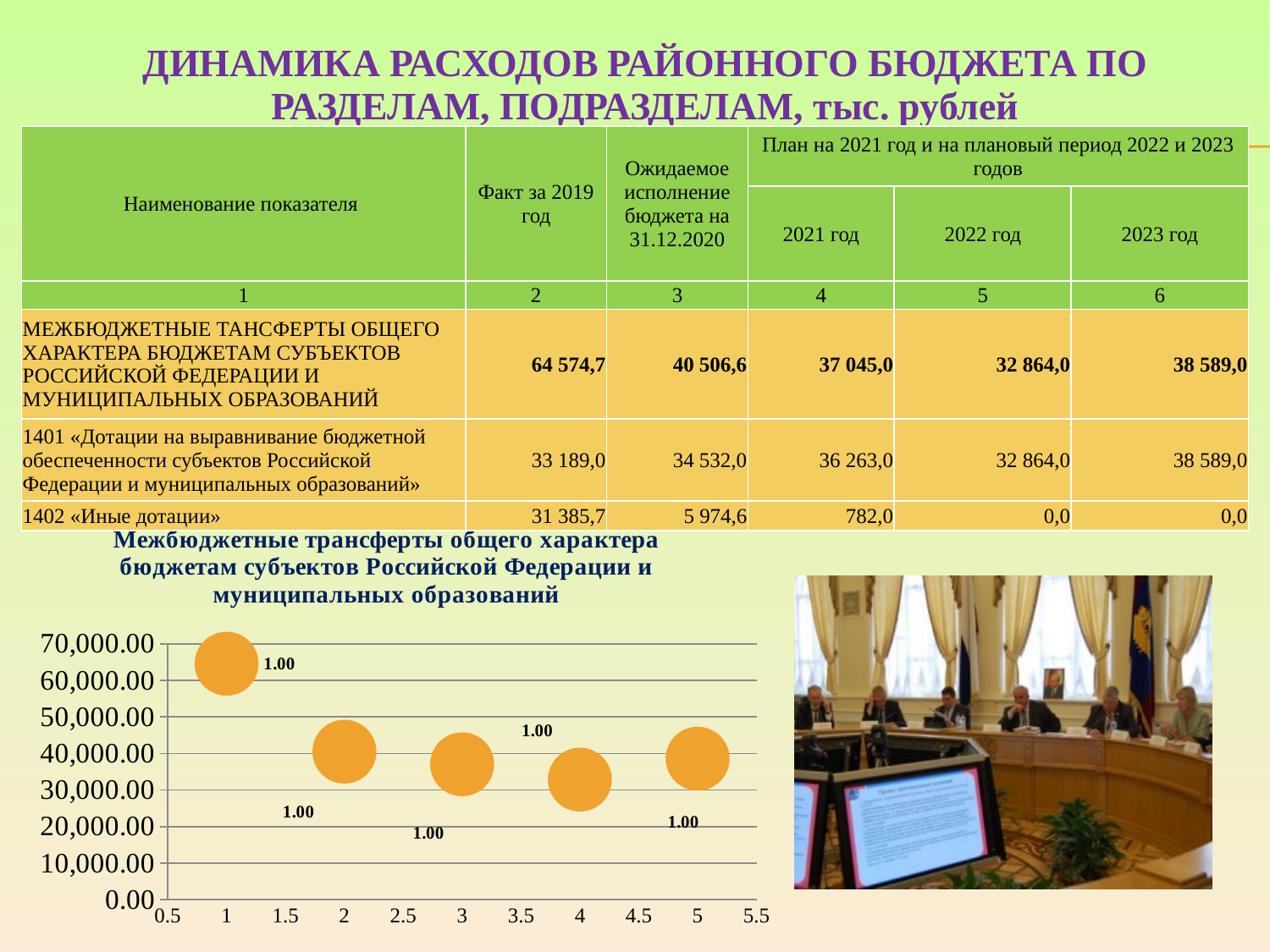
Is the value of the bubble at x = 2 greater or less than 30,000.00? greater Is the value of the bubble at x = 1 greater or less than 60,000.00? greater Is the value of the bubble at x = 5 greater or less than 50,000.00? less Which bubble has the larger value, the one at x = 2 or the one at x = 4? x = 2 Which bubble has the larger value, the one at x = 1 or the one at x = 3? x = 1 What kind of chart is shown on the slide? bubble chart At which x-axis position is the lowest bubble in the chart? 4 What data label is printed next to each bubble in the chart? 1.00 Do the bubble values generally rise or fall from x = 1 to x = 4? fall At which x-axis position is the highest bubble in the chart? 1 How many bubbles (data points) are plotted in the chart? 5